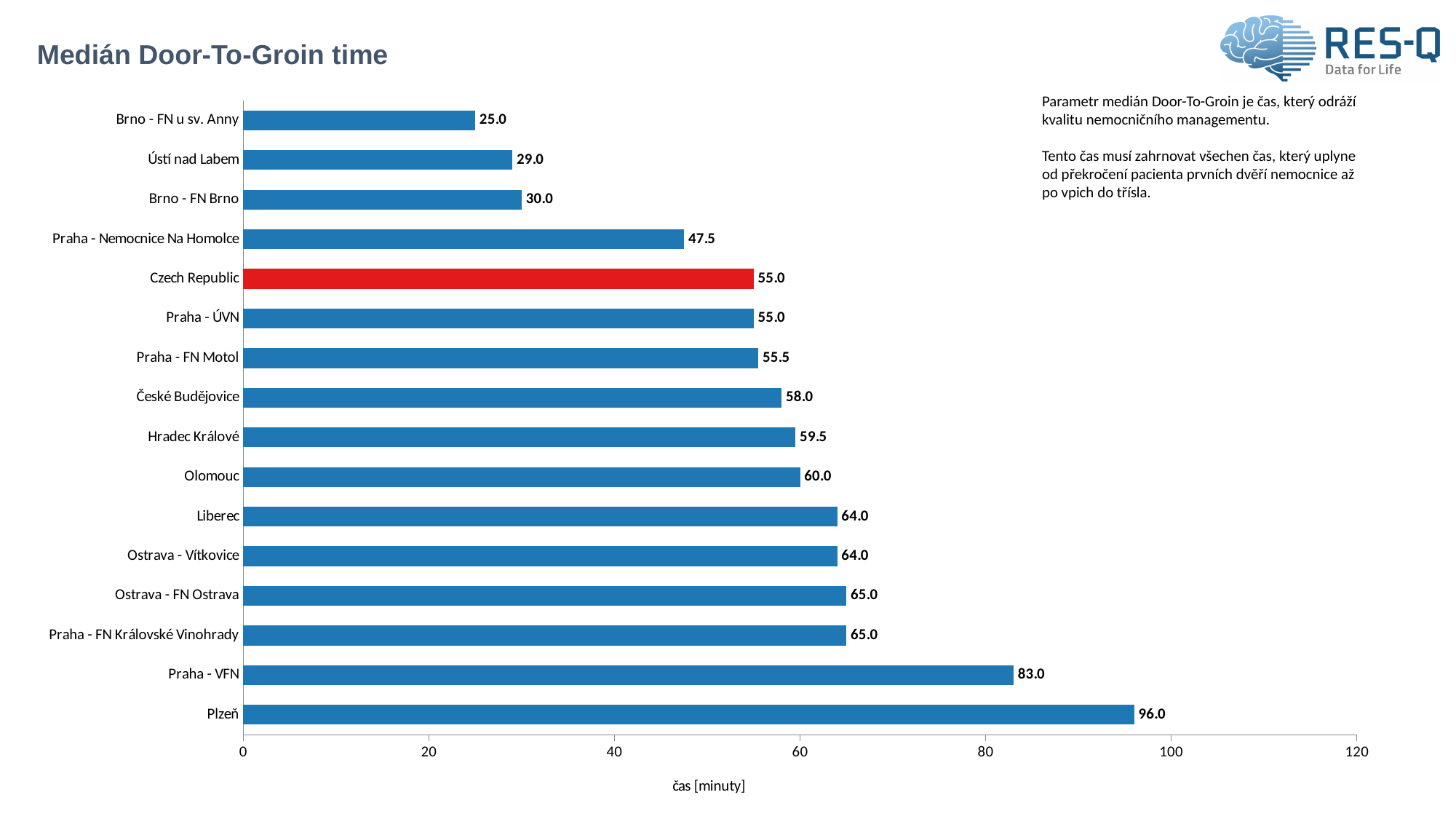
What is the value shown for Czech Republic? 55.0 What is the difference between the values for Czech Republic and Brno - FN u sv. Anny? 30.0 Which has a larger value, Liberec or Hradec Králové? Liberec What is the value shown for Praha - Nemocnice Na Homolce? 47.5 What is the median Door-To-Groin time for Plzeň? 96.0 What kind of chart is shown on the slide? bar chart How many categories are shown on the chart? 16 Which category has the highest median Door-To-Groin time? Plzeň Is the value for Praha - VFN greater or less than 80? greater What is the difference between the values for Plzeň and Praha - VFN? 13.0 Which bar is highlighted in red? Czech Republic Which category has the lowest median Door-To-Groin time? Brno - FN u sv. Anny